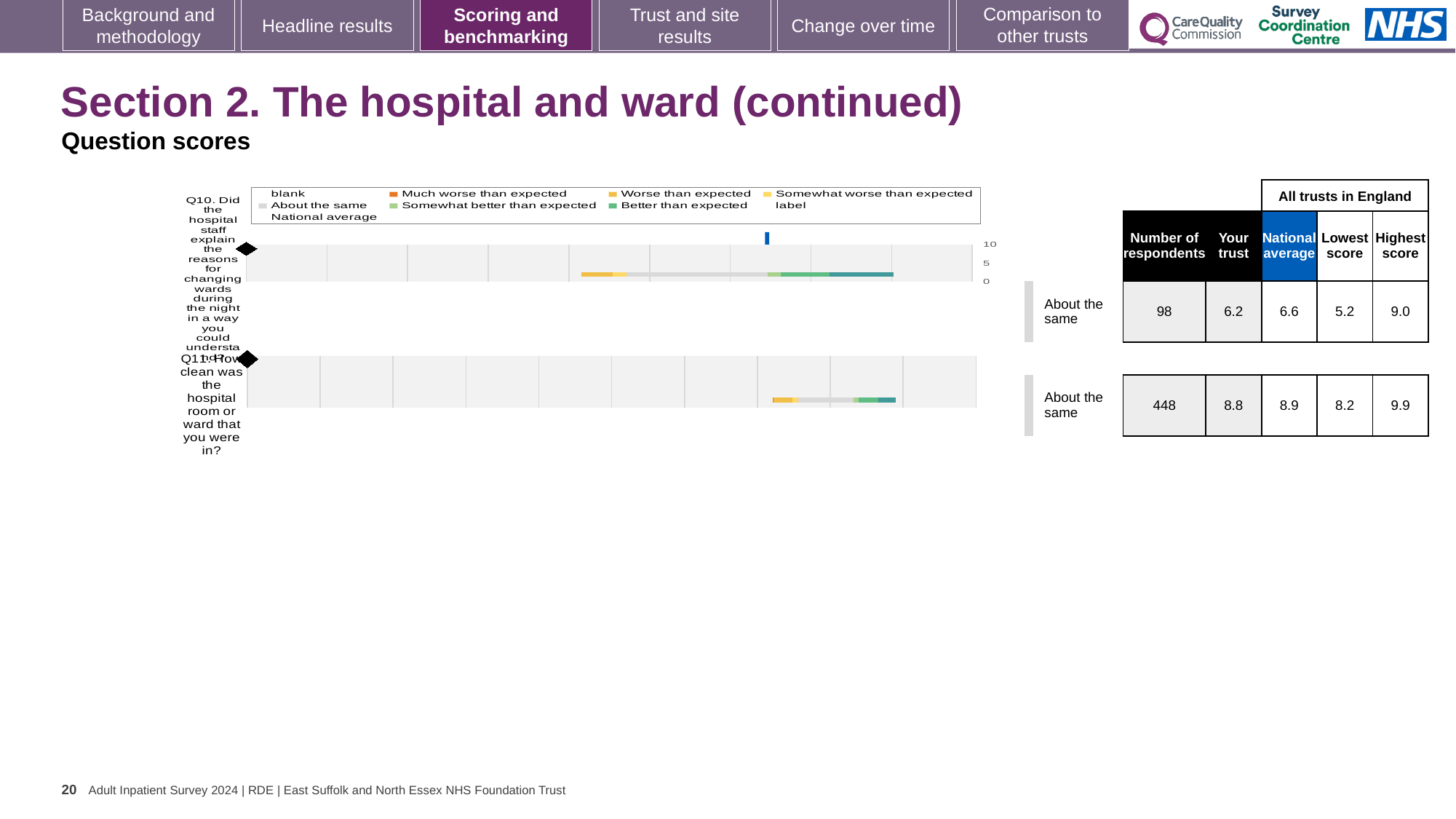
What is the highest score among all trusts in England for Q11? 9.9 What benchmarking category is shown for Q10? About the same What is the difference between the 'Your trust' scores for Q11 and Q10? 2.6 Which question has the higher 'Your trust' score, Q10 or Q11? Q11 How many questions are plotted in the question scores chart? 2 What is the national average score for Q10? 6.6 What is the 'Your trust' score for Q10 (explaining reasons for changing wards during the night)? 6.2 What is the 'Your trust' score for Q11 (how clean was the hospital room or ward)? 8.8 How many respondents answered Q11? 448 What is the national average score for Q11? 8.9 Is the 'Your trust' score for Q11 greater or less than 5 on the chart axis? greater What kind of chart is used to show the question scores for Q10 and Q11? bar chart